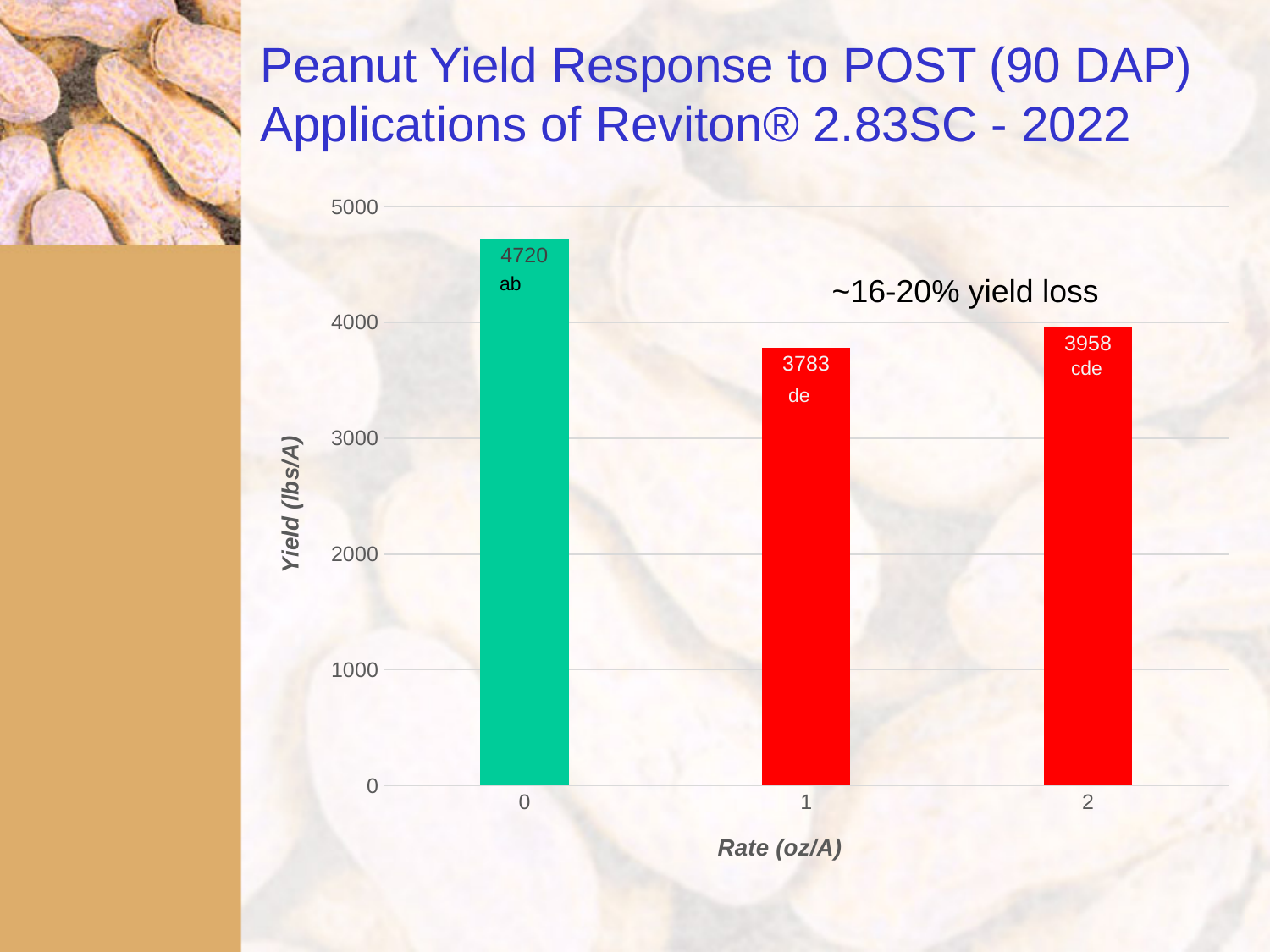
What is the yield (lbs/A) at a rate of 0 oz/A? 4720 What is the yield (lbs/A) at a rate of 2 oz/A? 3958 Which rate (oz/A) has the lowest yield? 1 What kind of chart is shown on the slide? bar chart Which has a higher yield, the 1 oz/A rate or the 2 oz/A rate? 2 oz/A Which rate (oz/A) has the highest yield? 0 How many rate categories are shown on the x axis? 3 What is the difference in yield between the 0 oz/A rate and the 1 oz/A rate? 937 Is the yield at the 2 oz/A rate greater or less than 4000? less What is the yield (lbs/A) at a rate of 1 oz/A? 3783 What is the label of the y axis? Yield (lbs/A) What is the difference in yield between the 2 oz/A rate and the 1 oz/A rate? 175